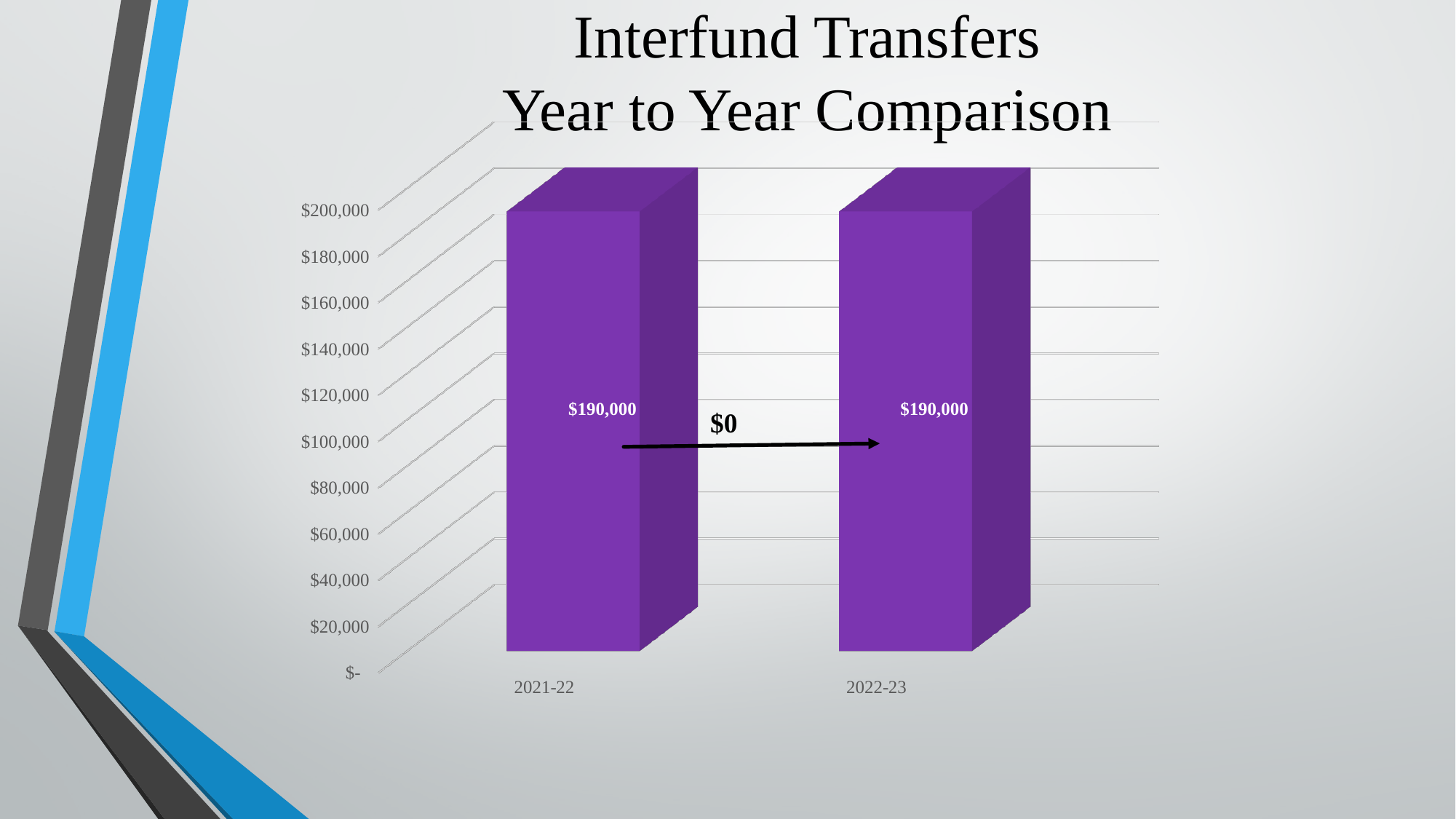
What is the highest value shown on the y axis? $200,000 What colour are the bars? purple What kind of chart is this? bar chart Is the value for 2021-22 greater or less than $100,000? greater Do the values rise, fall, or stay the same from 2021-22 to 2022-23? stay the same What is the title of the chart? Interfund Transfers Year to Year Comparison What is the difference between the 2022-23 value and the 2021-22 value? $0 Is the value for 2022-23 greater or less than $200,000? less What is the value for 2022-23? $190,000 What is the value for 2021-22? $190,000 How many categories are shown on the x axis? 2